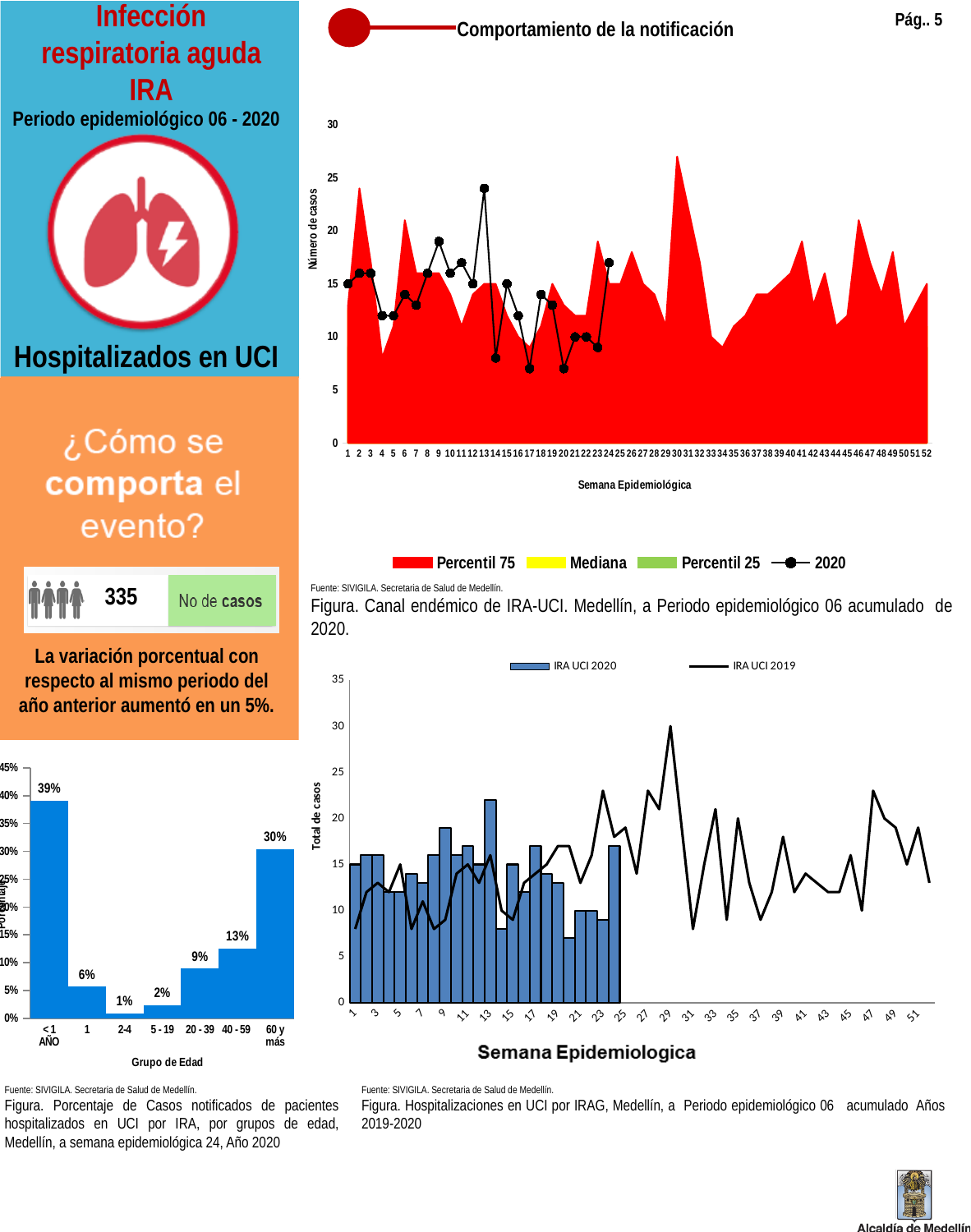
In the bar chart of percentage of cases by age group (bottom left), which age group has the lowest percentage? 2-4 How many series does the legend list in the 'Canal endémico de IRA-UCI' chart (top right)? 4 What kind of chart is the 'Porcentaje de Casos notificados ... por grupos de edad' figure (bottom left)? bar chart In the bar chart of percentage of cases by age group (bottom left), what is the value for the '40 - 59' group? 13% In the bar chart of percentage of cases by age group (bottom left), which is larger: the value for '20 - 39' or the value for '1'? 20 - 39 In the 'Canal endémico de IRA-UCI' chart (top right), is the 2020 value at semana epidemiológica 13 greater or less than 20? greater In the bar chart of percentage of cases by age group (bottom left), what is the value for the '< 1 AÑO' group? 39% How many age groups are shown in the bar chart of percentage of cases by age group (bottom left)? 7 In the bar chart of percentage of cases by age group (bottom left), which age group has the highest percentage? < 1 AÑO In the 'Hospitalizaciones en UCI por IRAG' chart (bottom right), is the IRA UCI 2019 value at semana 29 greater or less than 25? greater In the bar chart of percentage of cases by age group (bottom left), what is the value for the '60 y más' group? 30% In the bar chart of percentage of cases by age group (bottom left), what is the difference between the '< 1 AÑO' group and the '60 y más' group? 9%